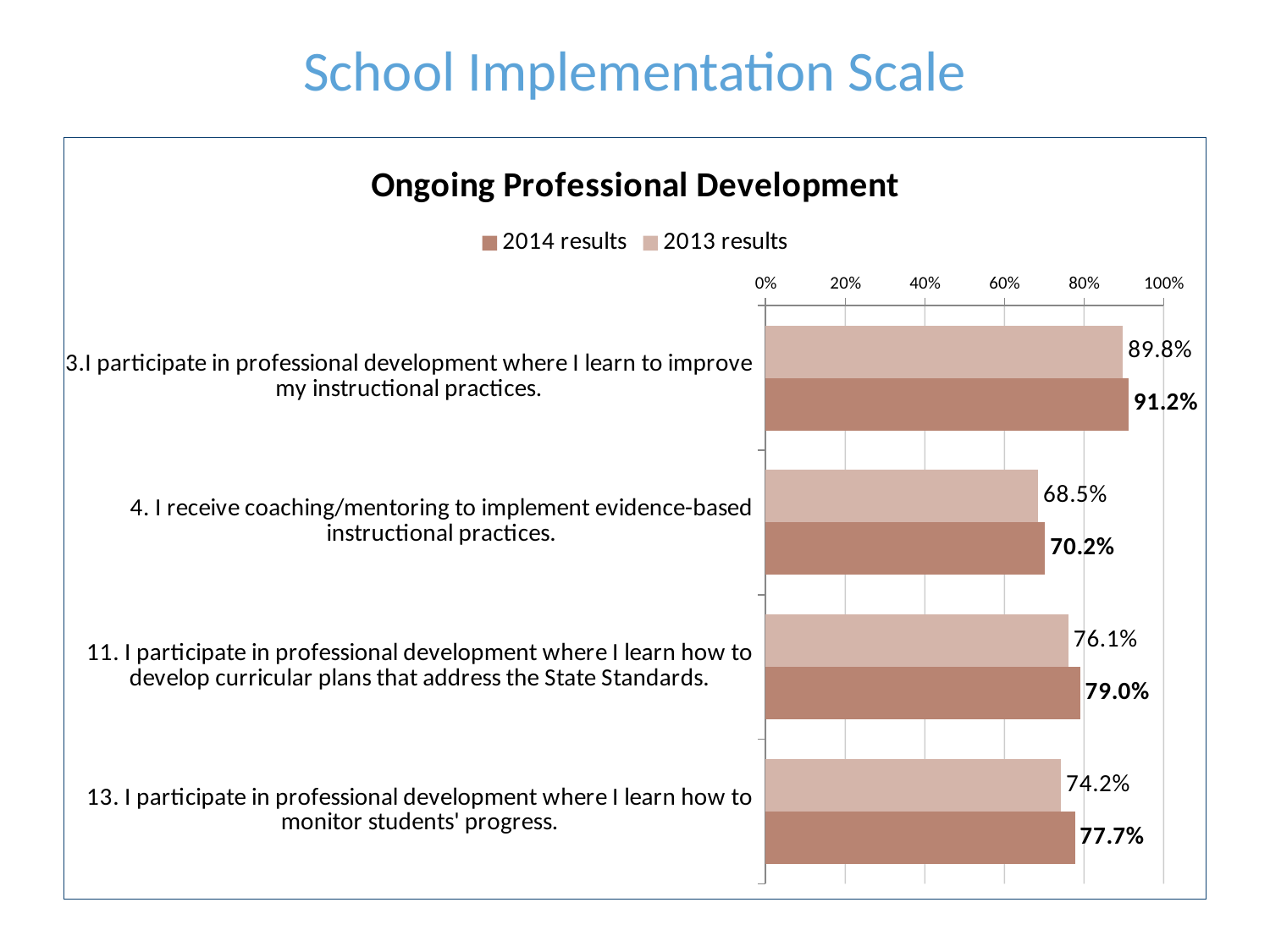
What is the 2013 result for item 4, 'I receive coaching/mentoring to implement evidence-based instructional practices'? 68.5% Which item has the highest 2014 result? 3. I participate in professional development where I learn to improve my instructional practices. How many survey items are shown in the chart? 4 What kind of chart is shown on the slide? Bar chart What is the title of the chart? Ongoing Professional Development Which is larger for item 13: the 2014 result or the 2013 result? 2014 result What is the 2014 result for item 3, 'I participate in professional development where I learn to improve my instructional practices'? 91.2% What is the 2014 result for item 13, about learning how to monitor students' progress? 77.7% What is the difference between the 2014 and 2013 results for item 11? 2.9% How many series does the legend list? 2 Which item has the lowest 2013 result? 4. I receive coaching/mentoring to implement evidence-based instructional practices. What is the 2013 result for item 11, about developing curricular plans that address the State Standards? 76.1%